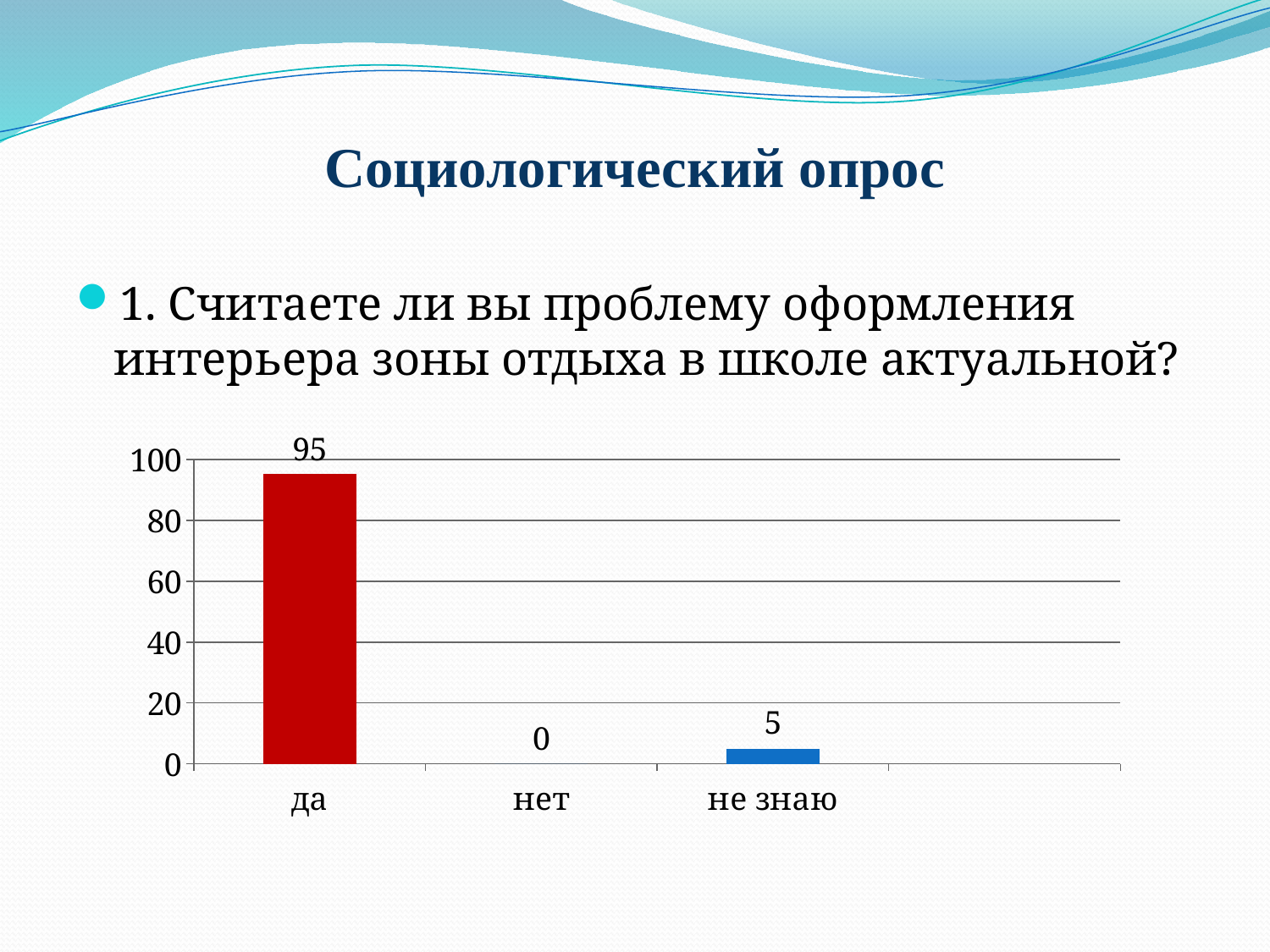
Is the value for "да" greater or less than 80? greater Which is larger, the value for "не знаю" or the value for "нет"? не знаю How many categories are shown on the x axis? 3 What colour is the bar for "да"? red What kind of chart is shown on the slide? bar chart What is the difference between the values for "да" and "не знаю"? 90 What is the value for "да"? 95 What is the value for "нет"? 0 What is the total of the three values shown in the chart? 100 Which category has the highest value? да Which category has the lowest value? нет What is the value for "не знаю"? 5